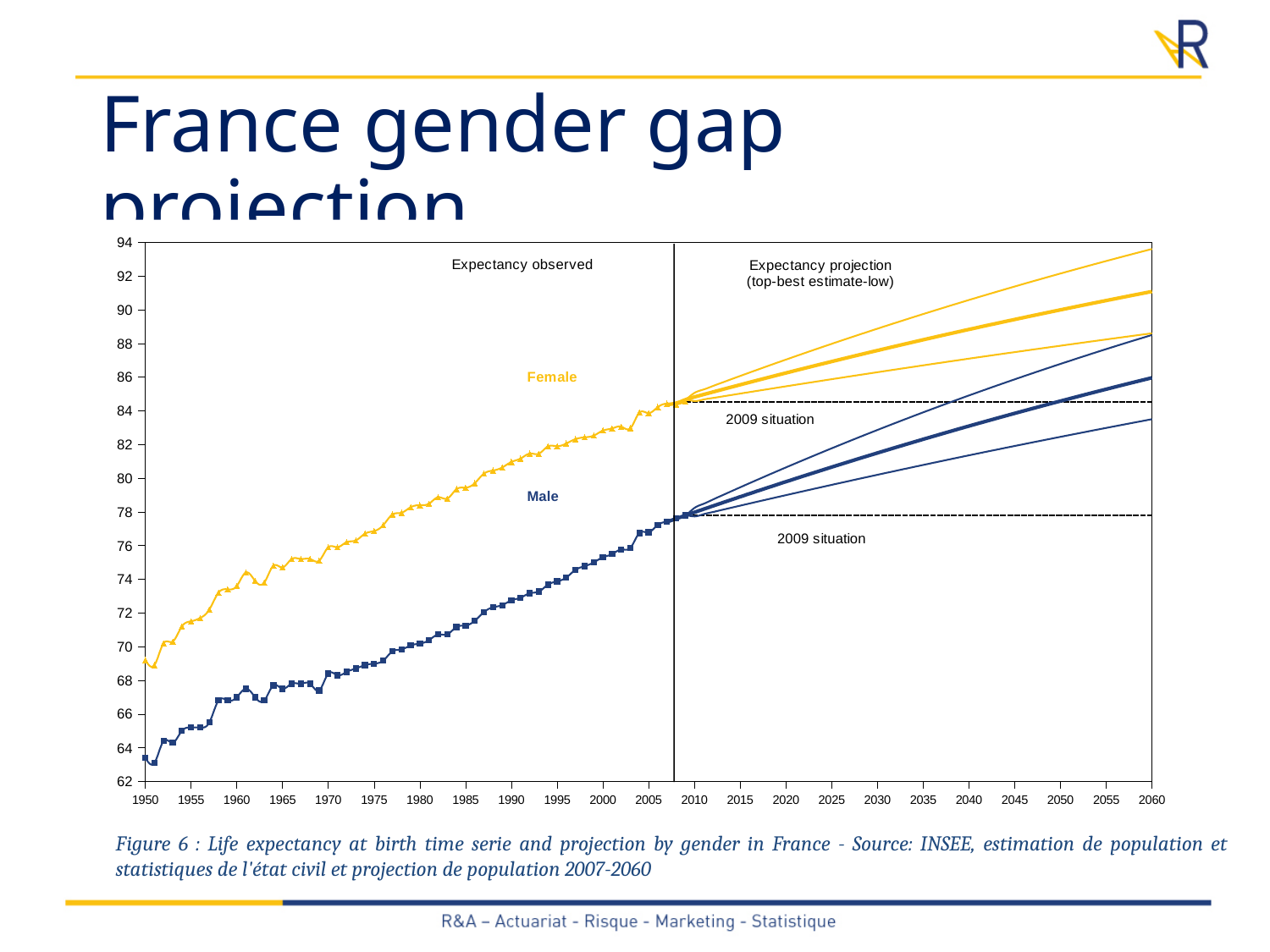
Is the Female life expectancy at the 2009 situation greater or less than 82? greater Is the Male life expectancy at the 2009 situation greater or less than 80? less Is the Female life expectancy in 1950 greater or less than 66? greater How many gender series are plotted on the chart? 2 What is the first year and the last year shown on the x axis? 1950 and 2060 What do the horizontal dashed lines on the right side of the chart represent? 2009 situation Which series has the higher life expectancy throughout the chart, Female or Male? Female What kind of chart is shown on the slide? line chart Does the observed Male life expectancy rise or fall from 1950 to 2008? rise